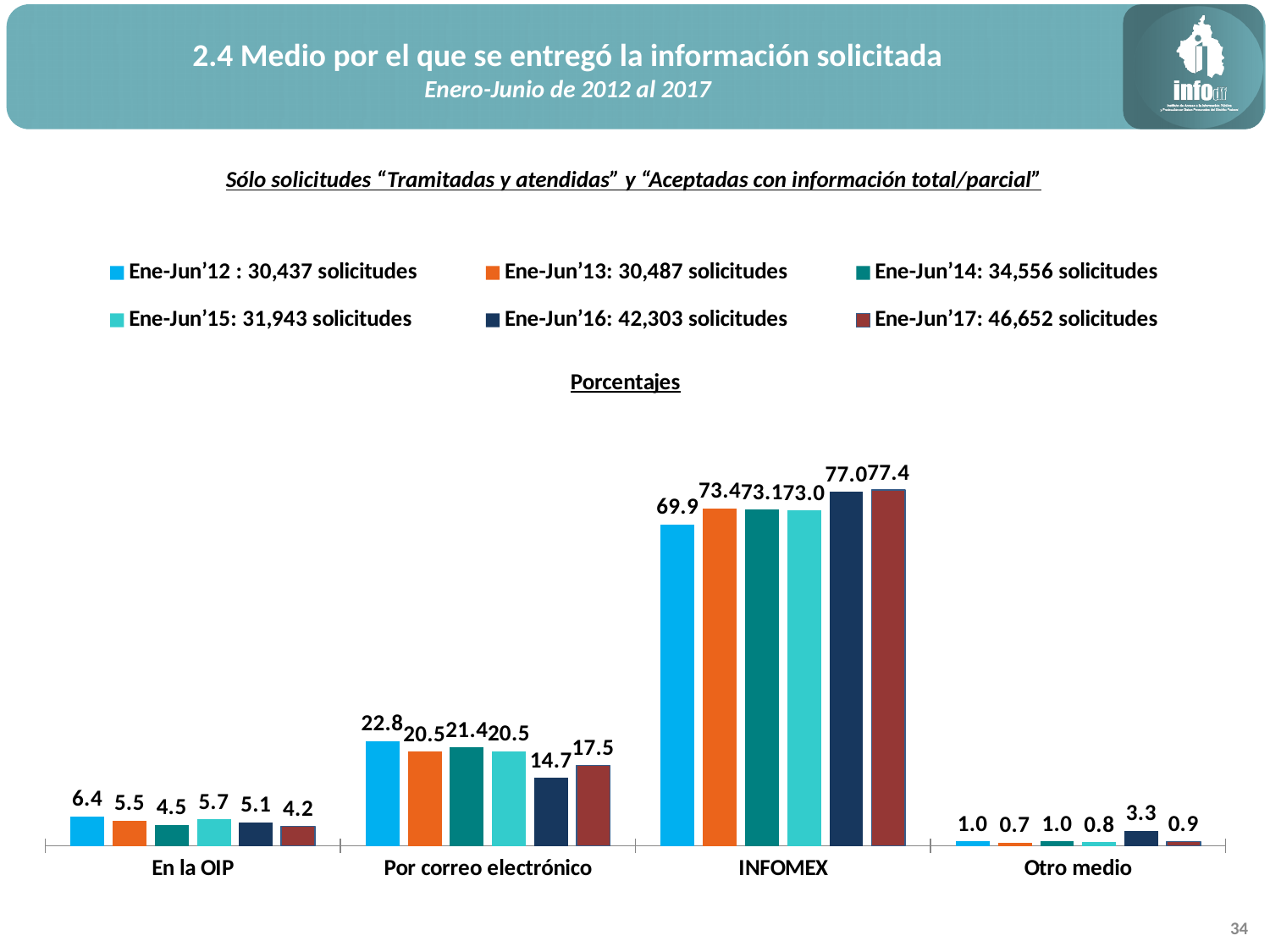
How many categories are shown on the x axis? 4 What type of chart is shown on the slide? Bar chart Do the values for INFOMEX rise or fall from Ene-Jun'16 to Ene-Jun'17? Rise According to the legend, how many solicitudes does the Ene-Jun'17 series represent? 46,652 solicitudes What is the value for INFOMEX in the Ene-Jun'17 series? 77.4 What is the value for Por correo electrónico in the Ene-Jun'12 series? 22.8 How many series does the legend list? 6 Which is larger for Por correo electrónico: the Ene-Jun'16 value or the Ene-Jun'17 value? Ene-Jun'17 What is the value for Otro medio in the Ene-Jun'16 series? 3.3 Which category has the highest value in the Ene-Jun'14 series? INFOMEX Which series has the lowest value for En la OIP? Ene-Jun'17 What is the difference between the Ene-Jun'17 and Ene-Jun'12 values for INFOMEX? 7.5